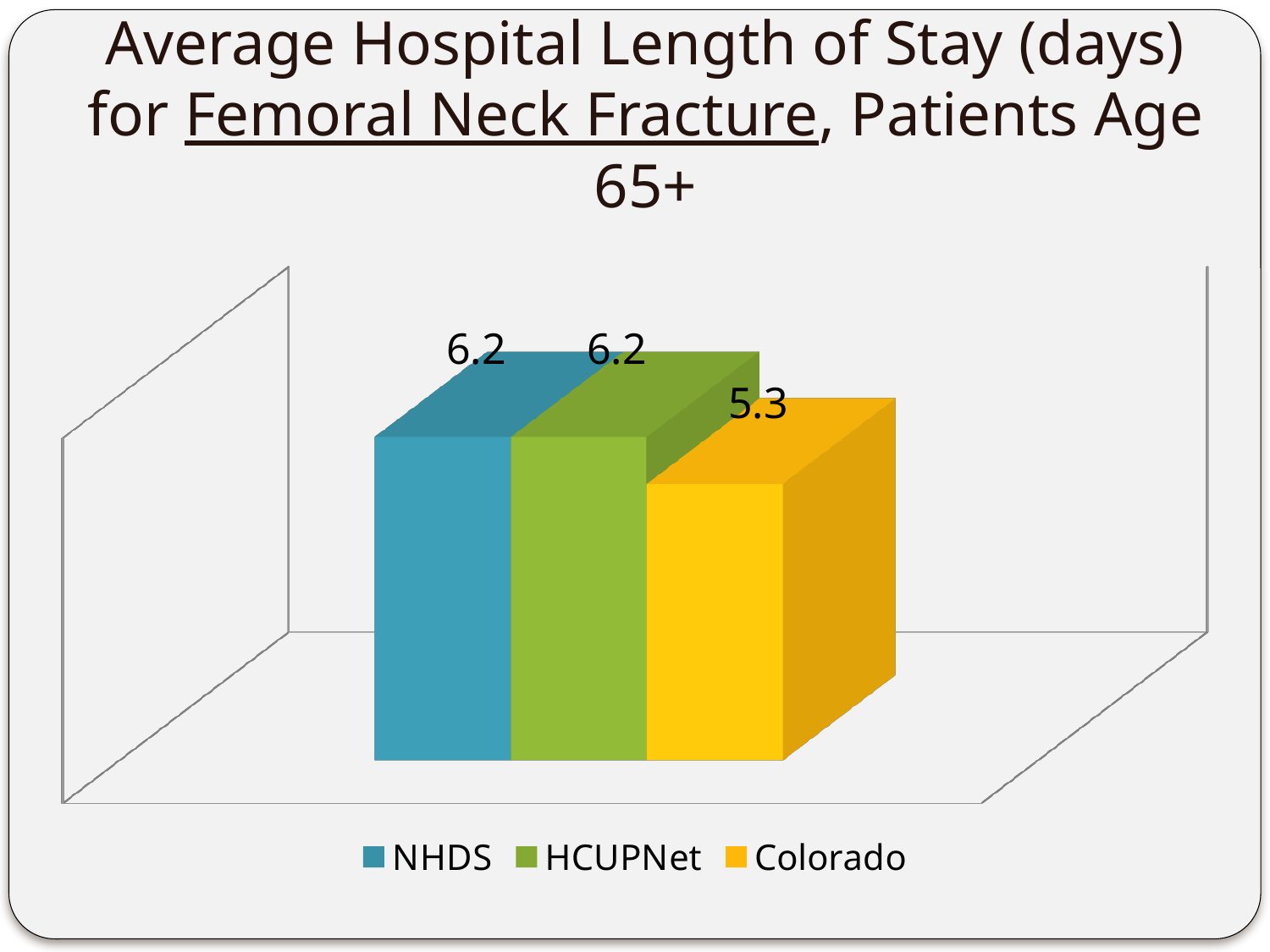
Which is larger, the value for NHDS or the value for Colorado? NHDS What colour is the bar for Colorado? yellow What is the average hospital length of stay for HCUPNet? 6.2 What is the average hospital length of stay for NHDS? 6.2 What is the difference between the NHDS value and the Colorado value? 0.9 Which series has the lowest average length of stay? Colorado What is the title of the chart? Average Hospital Length of Stay (days) for Femoral Neck Fracture, Patients Age 65+ What kind of chart is shown on the slide? bar chart Which is larger, the value for HCUPNet or the value for Colorado? HCUPNet How many series does the legend list? 3 What is the average hospital length of stay for Colorado? 5.3 What is the difference between the HCUPNet value and the Colorado value? 0.9